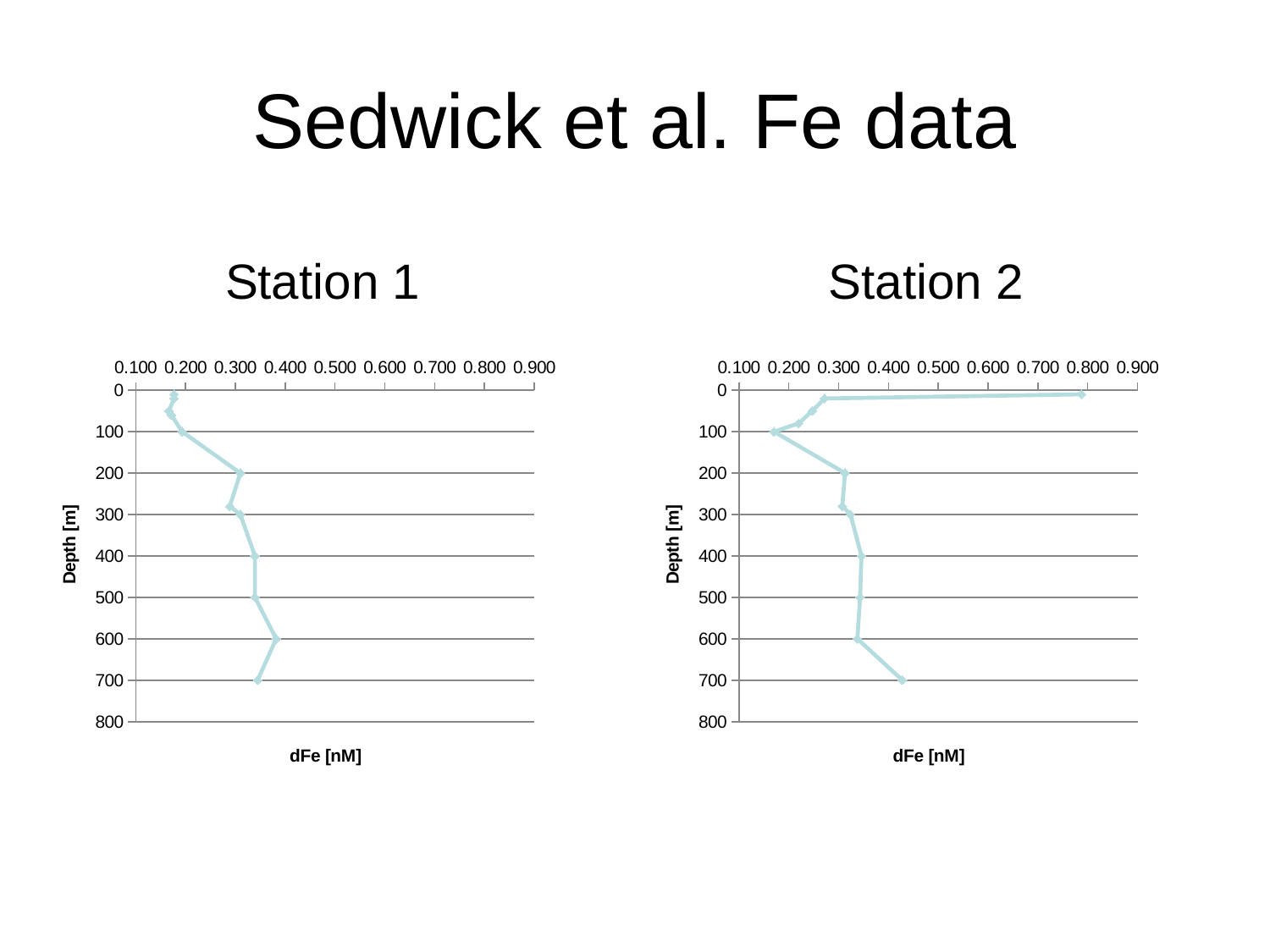
In the Station 1 chart, is the dFe value at 700 m depth greater or less than 0.300? greater In the Station 2 chart, at which depth is the dFe value lowest? 100 m In the Station 1 chart, what is the x-axis title? dFe [nM] In the Station 2 chart, what is the y-axis title? Depth [m] In the Station 1 chart, is the dFe value at 400 m depth greater or less than 0.300? greater How many charts are shown on the slide? 2 At 700 m depth, which station has the larger dFe value, Station 1 or Station 2? Station 2 In the Station 2 chart, is the dFe value at 100 m depth greater or less than 0.300? less What kind of chart is used for Station 1? line chart In the Station 1 chart, at which depth is the dFe value highest? 600 m